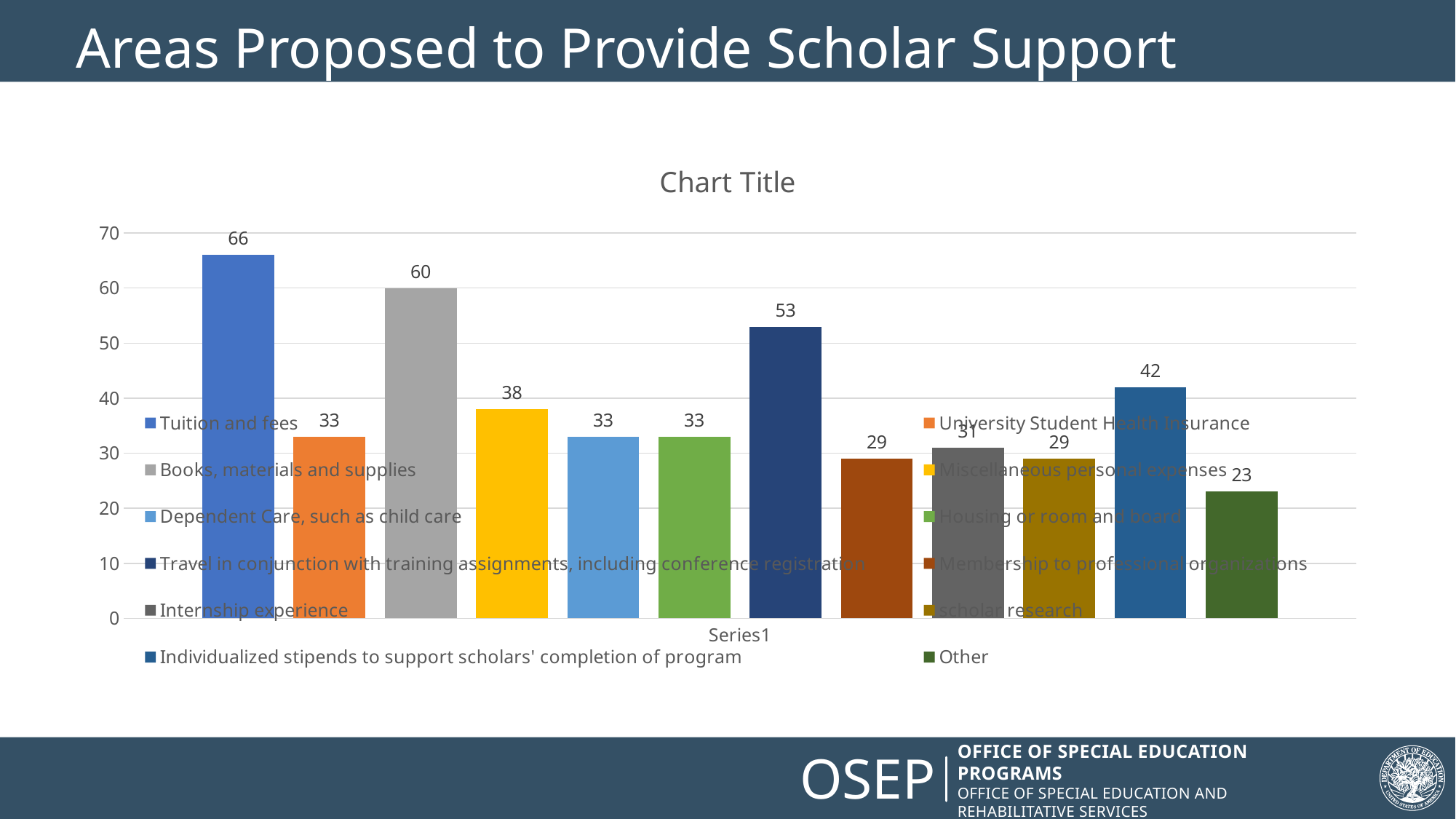
What is the value for Books, materials and supplies? 60 What kind of chart is shown on the slide? Bar chart What is the value for Tuition and fees? 66 How many entries does the legend list? 12 Which category has the highest value? Tuition and fees What is the difference between the values for Tuition and fees and Books, materials and supplies? 6 What is the value for Travel in conjunction with training assignments, including conference registration? 53 What is the title shown above the chart? Chart Title What is the value for Individualized stipends to support scholars' completion of program? 42 Which is larger, the value for Miscellaneous personal expenses or the value for Internship experience? Miscellaneous personal expenses Which category has the lowest value? Other How many bars are plotted in the chart? 12